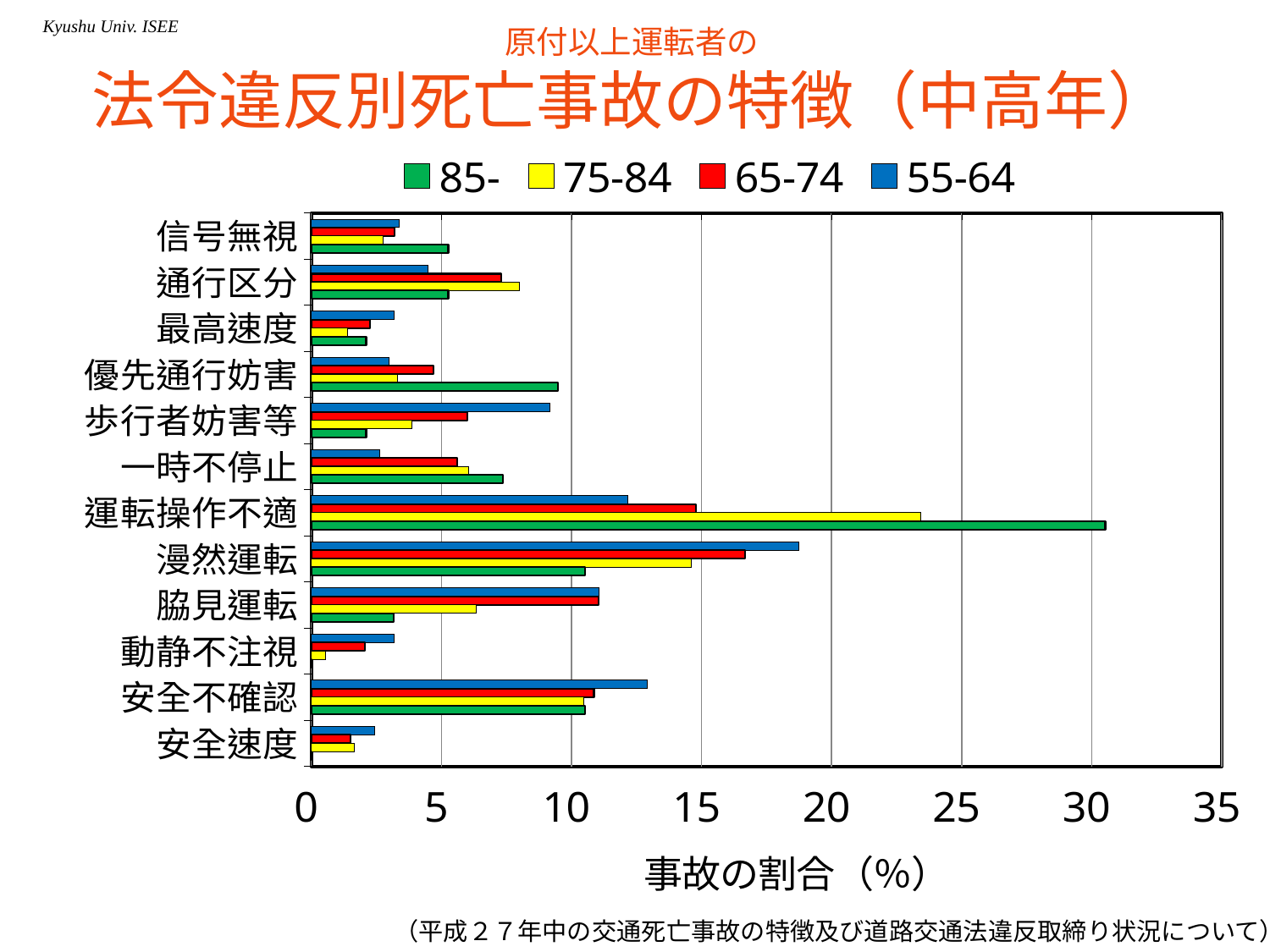
Is the value for 安全不確認 in the 55-64 series greater or less than 10? greater Which category has the highest value for the 85- series? 運転操作不適 For 脇見運転, which is larger: the 65-74 value or the 75-84 value? 65-74 Is the value for 運転操作不適 in the 75-84 series greater or less than 20? greater For 漫然運転, which is larger: the 55-64 value or the 85- value? 55-64 What is the label of the horizontal axis? 事故の割合（%） What kind of chart is shown on the slide? bar chart How many violation categories are shown on the vertical axis? 12 Which category has the highest value for the 55-64 series? 漫然運転 Is the value for 動静不注視 in the 75-84 series greater or less than 5? less How many series does the legend list? 4